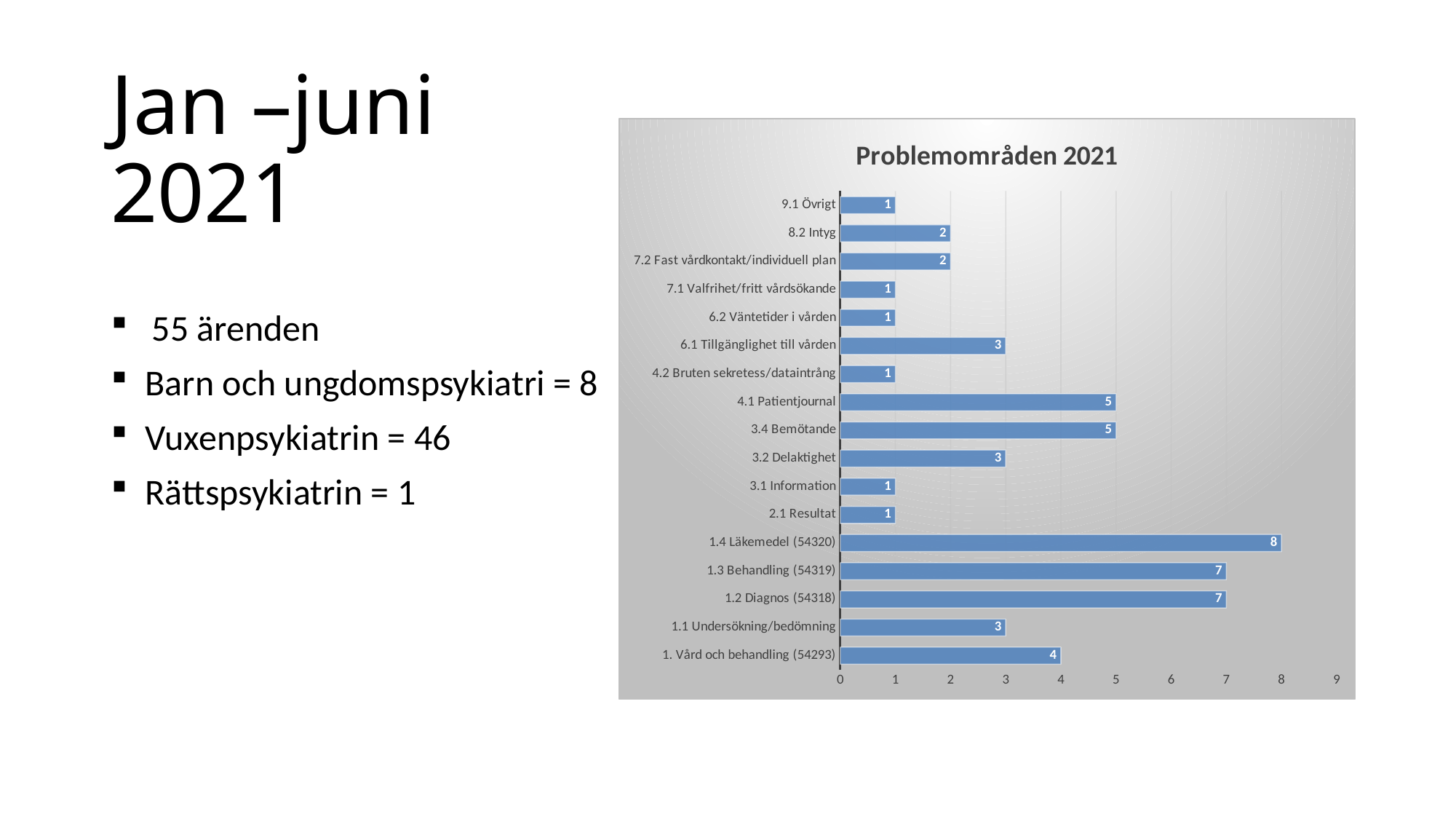
What is the lowest value shown in the chart? 1 What is the value for 4.1 Patientjournal? 5 What is the difference between the values for 1. Vård och behandling (54293) and 8.2 Intyg? 2 What is the value for 1.4 Läkemedel (54320)? 8 Which category has the highest value? 1.4 Läkemedel (54320) What is the value for 6.1 Tillgänglighet till vården? 3 How many categories are plotted in the chart? 17 What is the title of the chart? Problemområden 2021 What is the value for 1. Vård och behandling (54293)? 4 Which is larger, the value for 3.4 Bemötande or the value for 3.2 Delaktighet? 3.4 Bemötande What is the difference between the values for 1.4 Läkemedel (54320) and 1.3 Behandling (54319)? 1 What kind of chart is shown on the slide? Bar chart